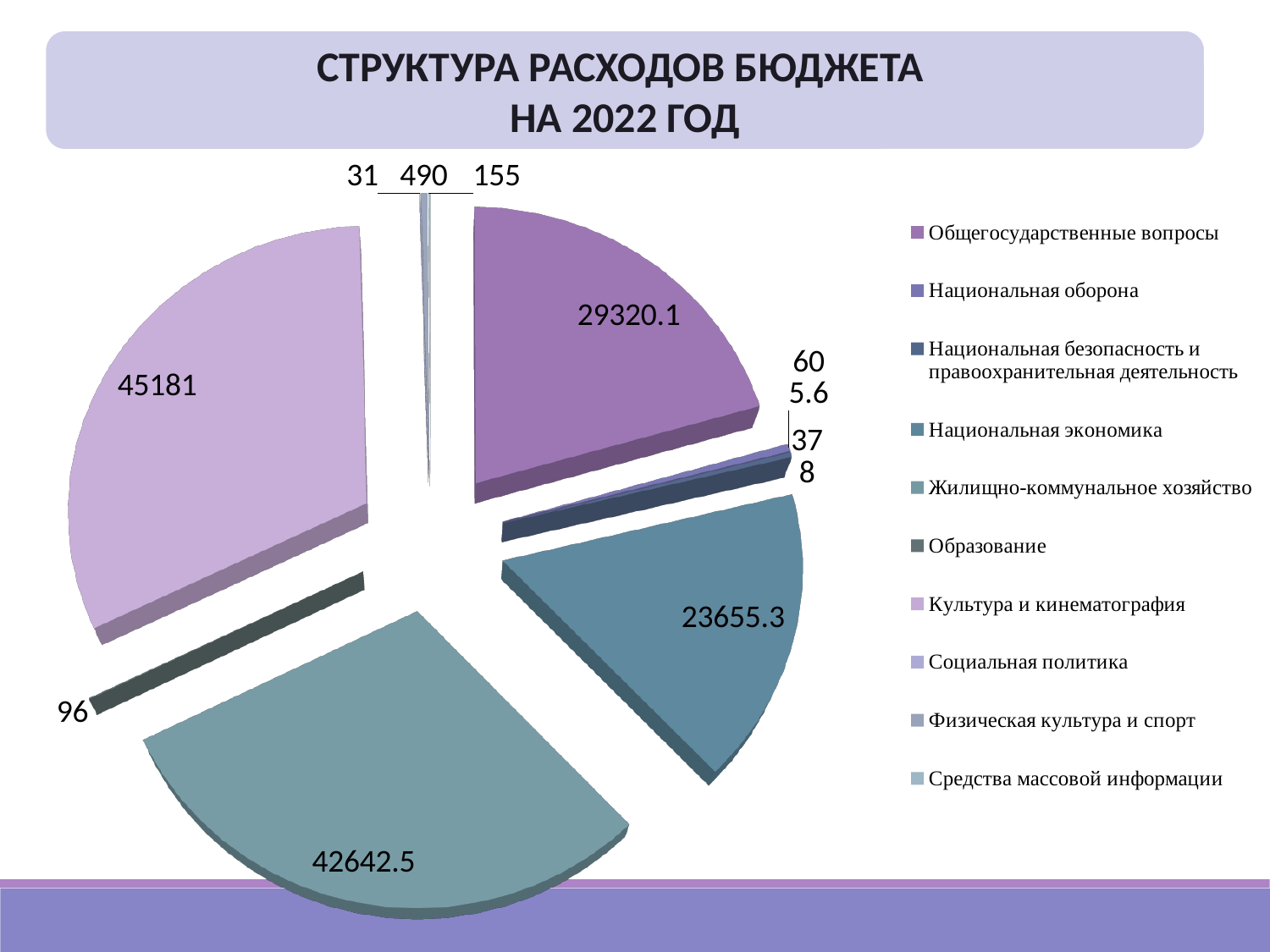
What is the title of the chart on the slide? СТРУКТУРА РАСХОДОВ БЮДЖЕТА НА 2022 ГОД Which category has the largest slice of the pie? Культура и кинематография What is the value shown for Национальная экономика? 23655.3 What is the difference between the values for Общегосударственные вопросы and Национальная экономика? 5664.8 Which is larger: Жилищно-коммунальное хозяйство or Национальная экономика? Жилищно-коммунальное хозяйство What type of chart is shown on the slide? Pie chart What is the value shown for Жилищно-коммунальное хозяйство? 42642.5 What is the value shown for Общегосударственные вопросы? 29320.1 What is the value shown for Образование? 96 What is the value shown for Культура и кинематография? 45181 What is the difference between the values for Культура и кинематография and Жилищно-коммунальное хозяйство? 2538.5 How many categories does the legend of the pie chart list? 10